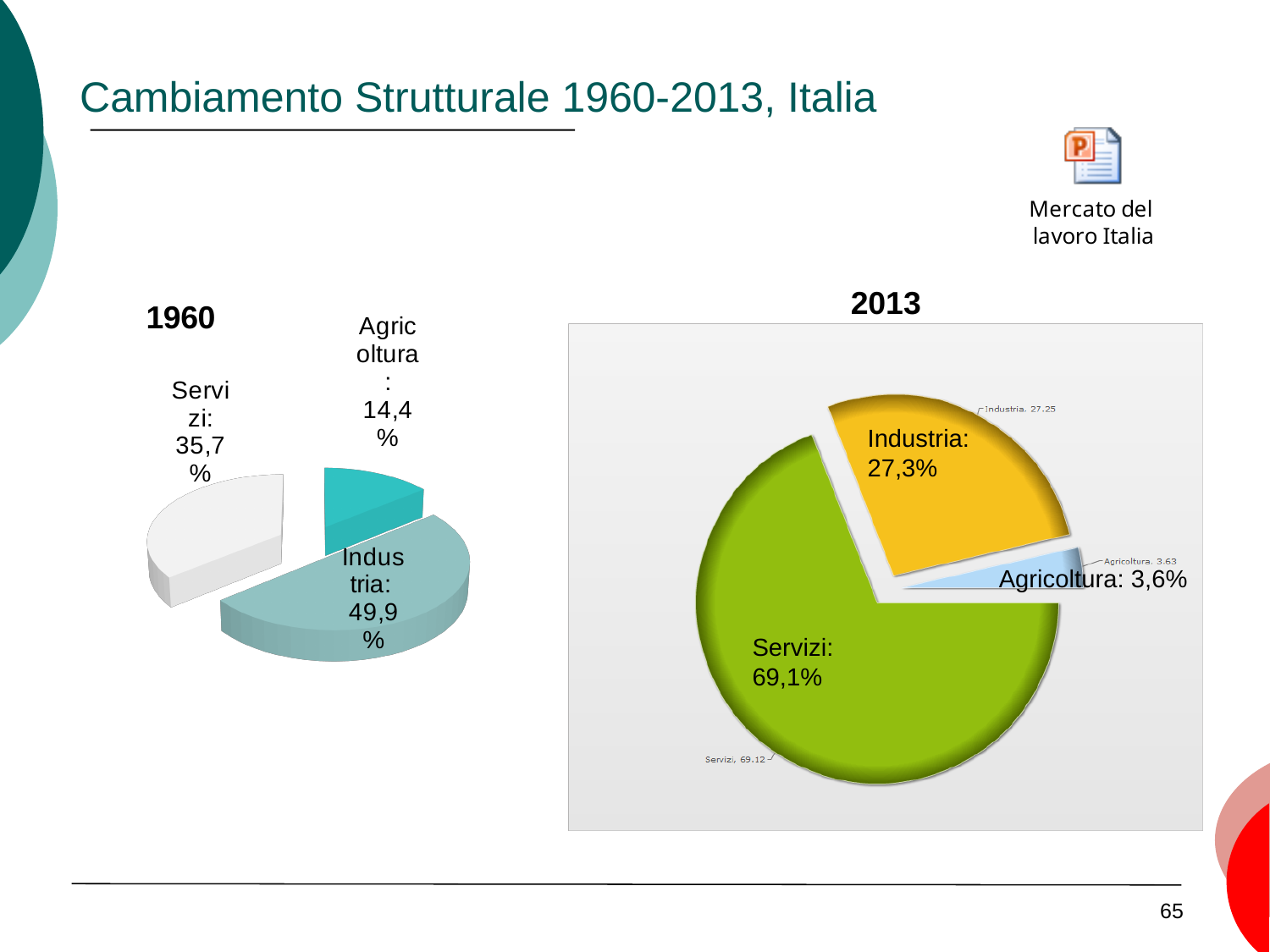
What type of chart is used for the 1960 data? Pie chart In the 2013 pie chart, what share does Servizi have? 69,1% In the 1960 pie chart, what share does Agricoltura have? 14,4% How many sectors are shown in the 2013 pie chart? 3 In the 2013 pie chart, which sector has the smallest share? Agricoltura In the 1960 pie chart, what is the difference between the Industria share and the Servizi share? 14,2% In the 2013 pie chart, what share does Industria have? 27,3% In the 1960 pie chart, which sector has the largest share? Industria In the 2013 pie chart, what share does Agricoltura have? 3,6% In the 1960 pie chart, what share does Servizi have? 35,7% In the 1960 pie chart, what share does Industria have? 49,9% In the 2013 pie chart, which is larger, Industria or Agricoltura? Industria